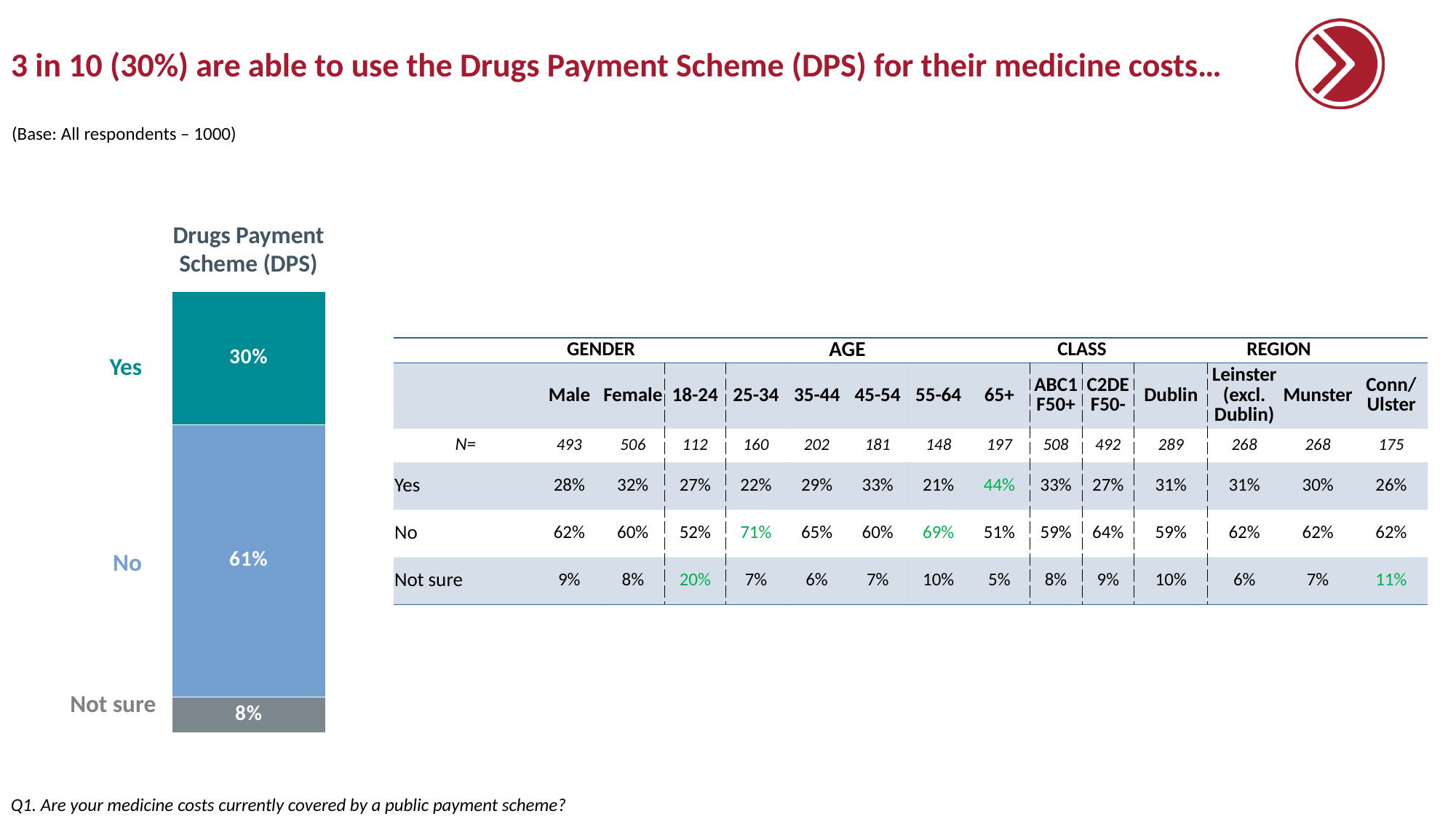
Which is larger in the Drugs Payment Scheme (DPS) chart, the 'Yes' segment or the 'Not sure' segment? Yes What colour is the 'Yes' segment in the Drugs Payment Scheme (DPS) chart? Teal What percentage of respondents answered 'No' in the Drugs Payment Scheme (DPS) chart? 61% How many response categories are shown in the Drugs Payment Scheme (DPS) chart? 3 What is the difference in percentage points between the 'No' and 'Yes' segments in the Drugs Payment Scheme (DPS) chart? 31 Which response has the smallest share in the Drugs Payment Scheme (DPS) chart? Not sure What is the title of the stacked bar chart on the slide? Drugs Payment Scheme (DPS) What kind of chart is used to show the Drugs Payment Scheme (DPS) responses? Stacked bar chart Which response has the largest share in the Drugs Payment Scheme (DPS) chart? No What percentage of respondents answered 'Yes' in the Drugs Payment Scheme (DPS) chart? 30% What is the total of the three segments in the Drugs Payment Scheme (DPS) stacked bar? 99% What percentage of respondents answered 'Not sure' in the Drugs Payment Scheme (DPS) chart? 8%